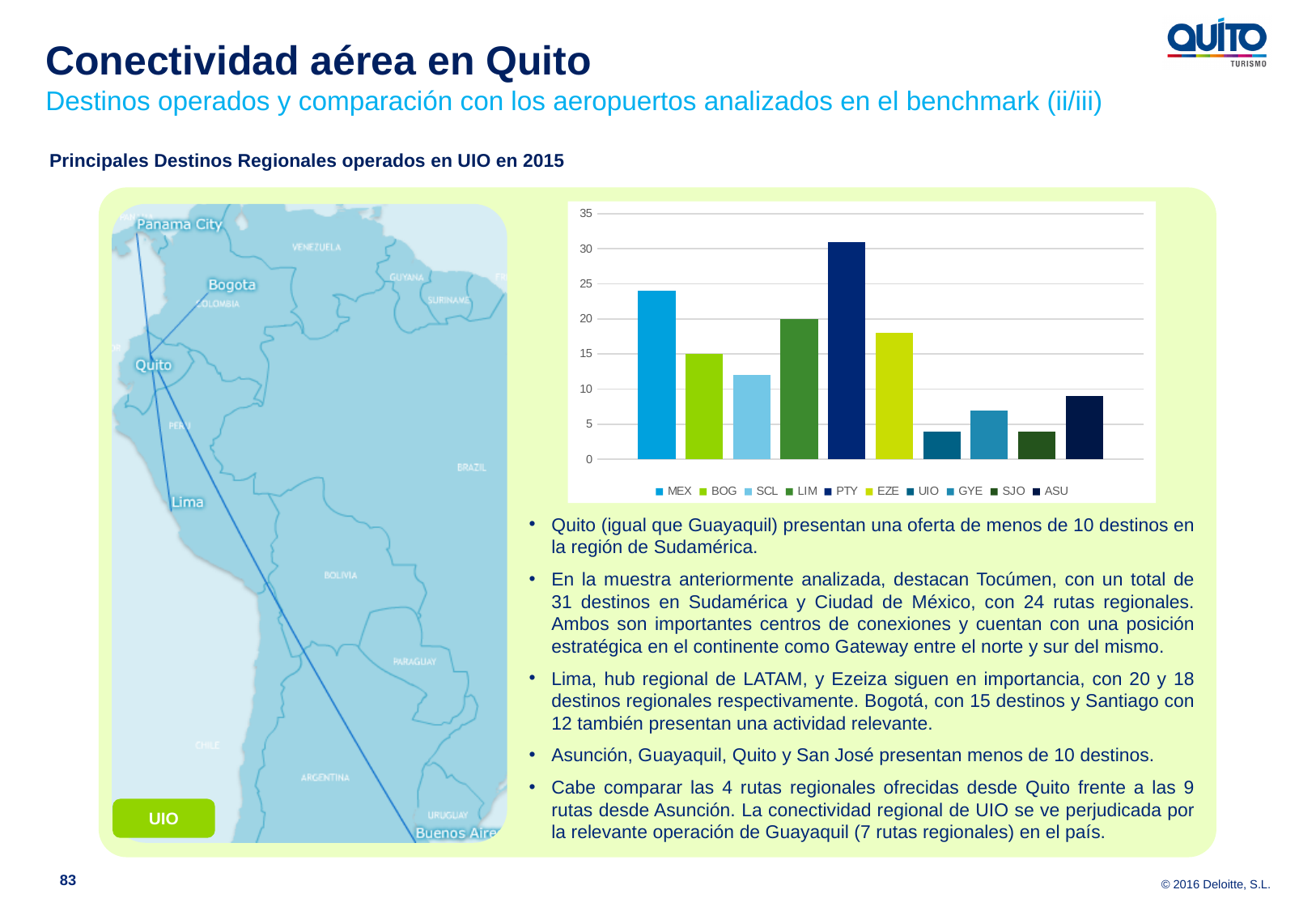
Which is larger, the value for MEX or the value for BOG? MEX Is the value for UIO greater or less than 5? less What is the value for LIM in the chart? 20 What is the heading printed above the chart and map? Principales Destinos Regionales operados en UIO en 2015 What kind of chart is shown on the slide? bar chart Is the value for PTY greater or less than 30? greater Is the value for ASU greater or less than 10? less How many airports (bars) are shown in the chart? 10 What is the difference between the values for LIM and BOG? 5 Which airport has the highest number of regional destinations in the chart? PTY How many entries does the chart legend list? 10 What is the value for BOG in the chart? 15